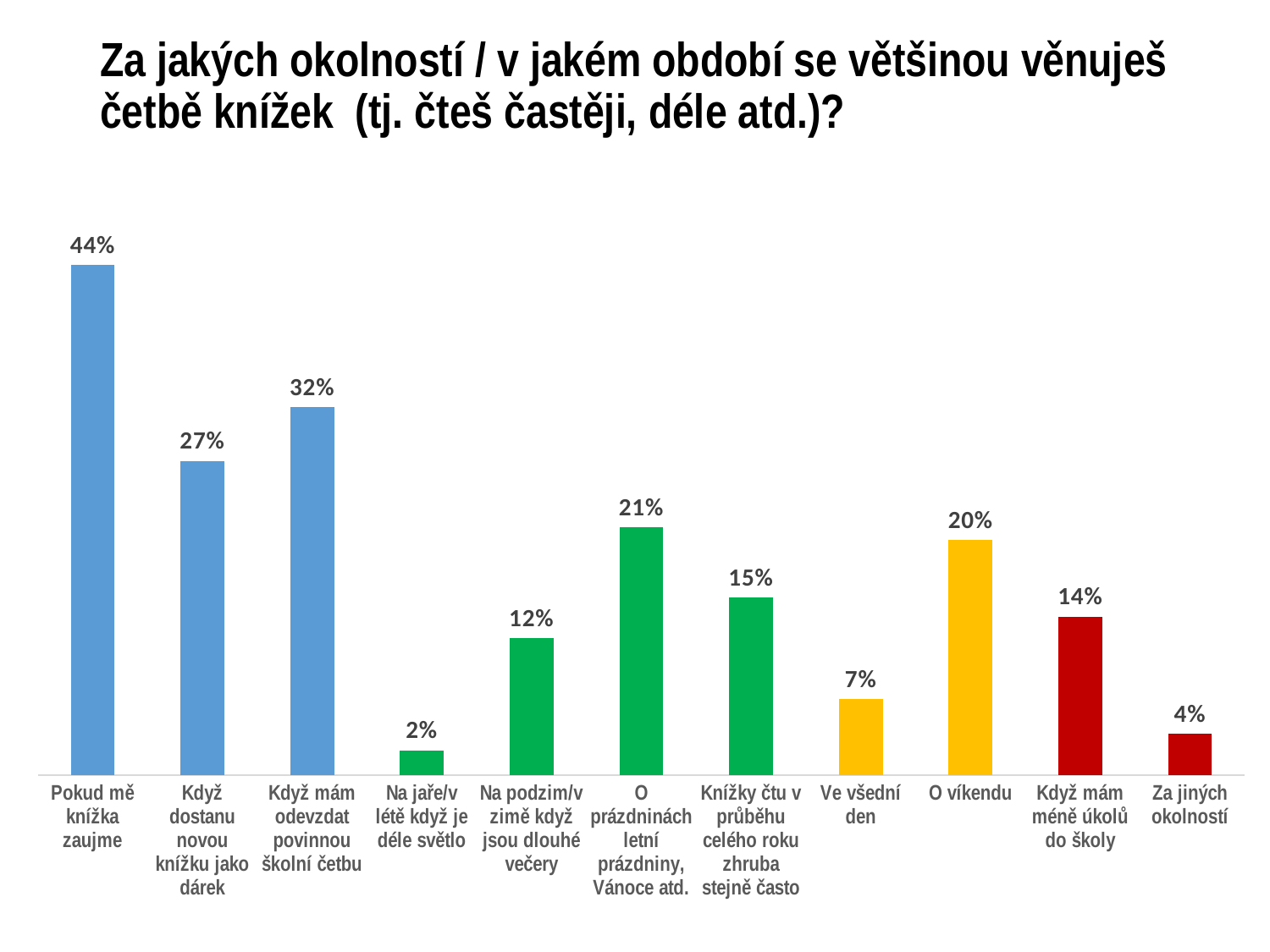
What is the value for "Pokud mě knížka zaujme"? 44% What kind of chart is shown on the slide? Bar chart What is the value for "Na podzim/v zimě když jsou dlouhé večery"? 12% What colour are the bars for "Ve všední den" and "O víkendu"? Yellow Which category has the highest value? Pokud mě knížka zaujme What is the difference between "Když mám odevzdat povinnou školní četbu" and "Když dostanu novou knížku jako dárek"? 5% What is the value for "O víkendu"? 20% How many categories are shown in the chart? 11 Which is larger: "Když mám méně úkolů do školy" or "Za jiných okolností"? Když mám méně úkolů do školy Which is larger: "O prázdninách letní prázdniny, Vánoce atd." or "Knížky čtu v průběhu celého roku zhruba stejně často"? O prázdninách letní prázdniny, Vánoce atd. Which category has the lowest value? Na jaře/v létě když je déle světlo What is the difference between "O víkendu" and "Ve všední den"? 13%